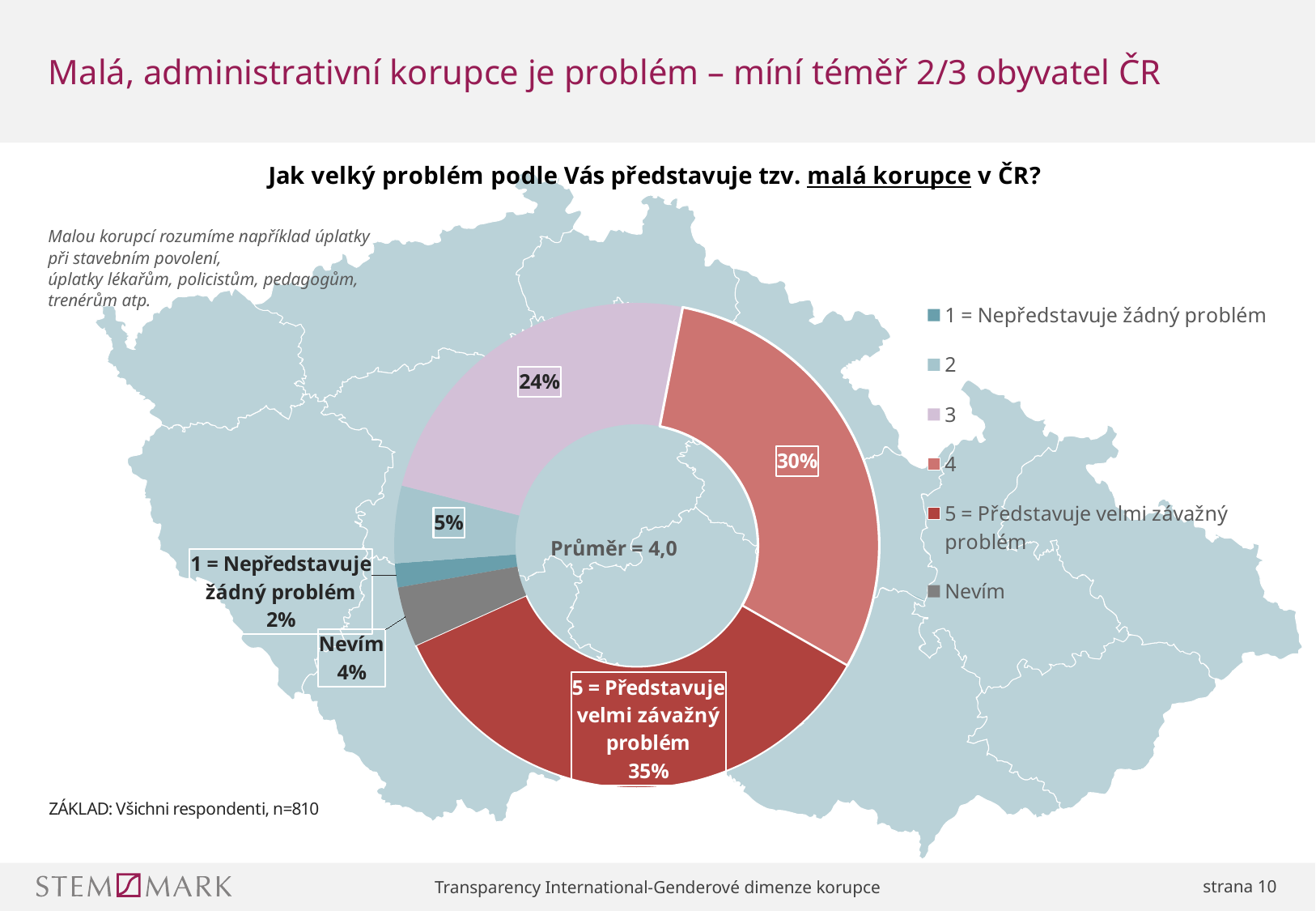
Which category has the largest share of the donut chart? 5 = Představuje velmi závažný problém What average value (Průměr) is printed in the centre of the chart? 4,0 What share of respondents answered "Nevím"? 4% Which category has the smallest share of the donut chart? 1 = Nepředstavuje žádný problém Which is larger, the share for category 2 or the share for "Nevím"? Category 2 What percentage is shown for category 4? 30% What is the difference in percentage points between category 3 and category 2? 19 What share of respondents chose "5 = Představuje velmi závažný problém"? 35% What type of chart is shown on the slide? Pie (donut) chart How many categories does the legend list? 6 What percentage is shown for category 3? 24% What is the difference in percentage points between category 5 and category 4? 5